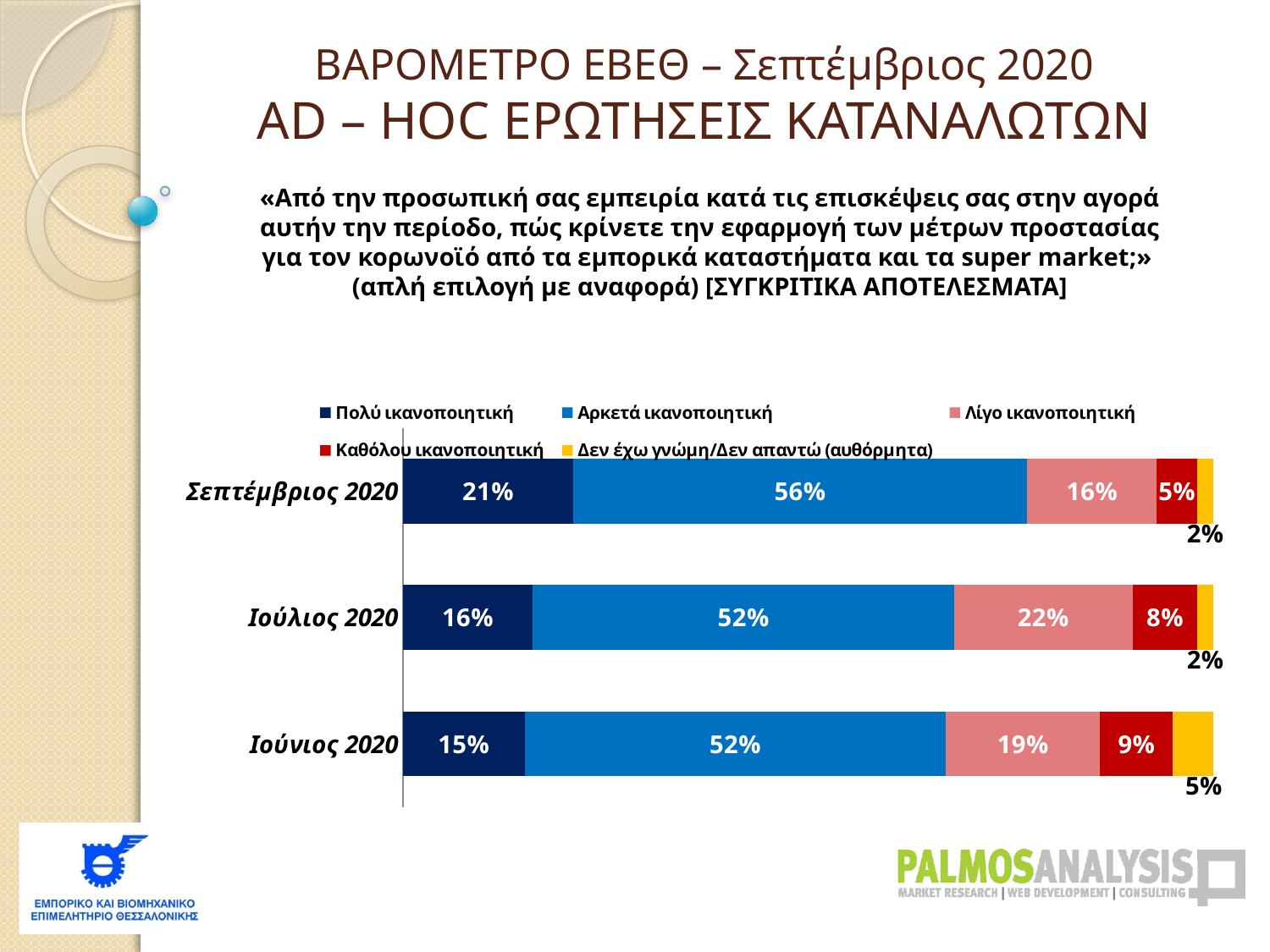
What is the value for Αρκετά ικανοποιητική in Ιούλιος 2020? 52% What is the total of the stacked bar for Σεπτέμβριος 2020? 100% What is the value for Λίγο ικανοποιητική in Ιούνιος 2020? 19% Which period has the highest value for Πολύ ικανοποιητική? Σεπτέμβριος 2020 What is the difference between the Λίγο ικανοποιητική values for Ιούλιος 2020 and Σεπτέμβριος 2020? 6% How many series does the legend list? 5 What is the value for Πολύ ικανοποιητική in Σεπτέμβριος 2020? 21% How many categories (time periods) are shown on the chart? 3 What is the value for Δεν έχω γνώμη/Δεν απαντώ (αυθόρμητα) in Ιούνιος 2020? 5% Which period has the lowest value for Καθόλου ικανοποιητική? Σεπτέμβριος 2020 Which is larger: Καθόλου ικανοποιητική in Ιούνιος 2020 or in Ιούλιος 2020? Ιούνιος 2020 What type of chart is shown on the slide? Stacked bar chart